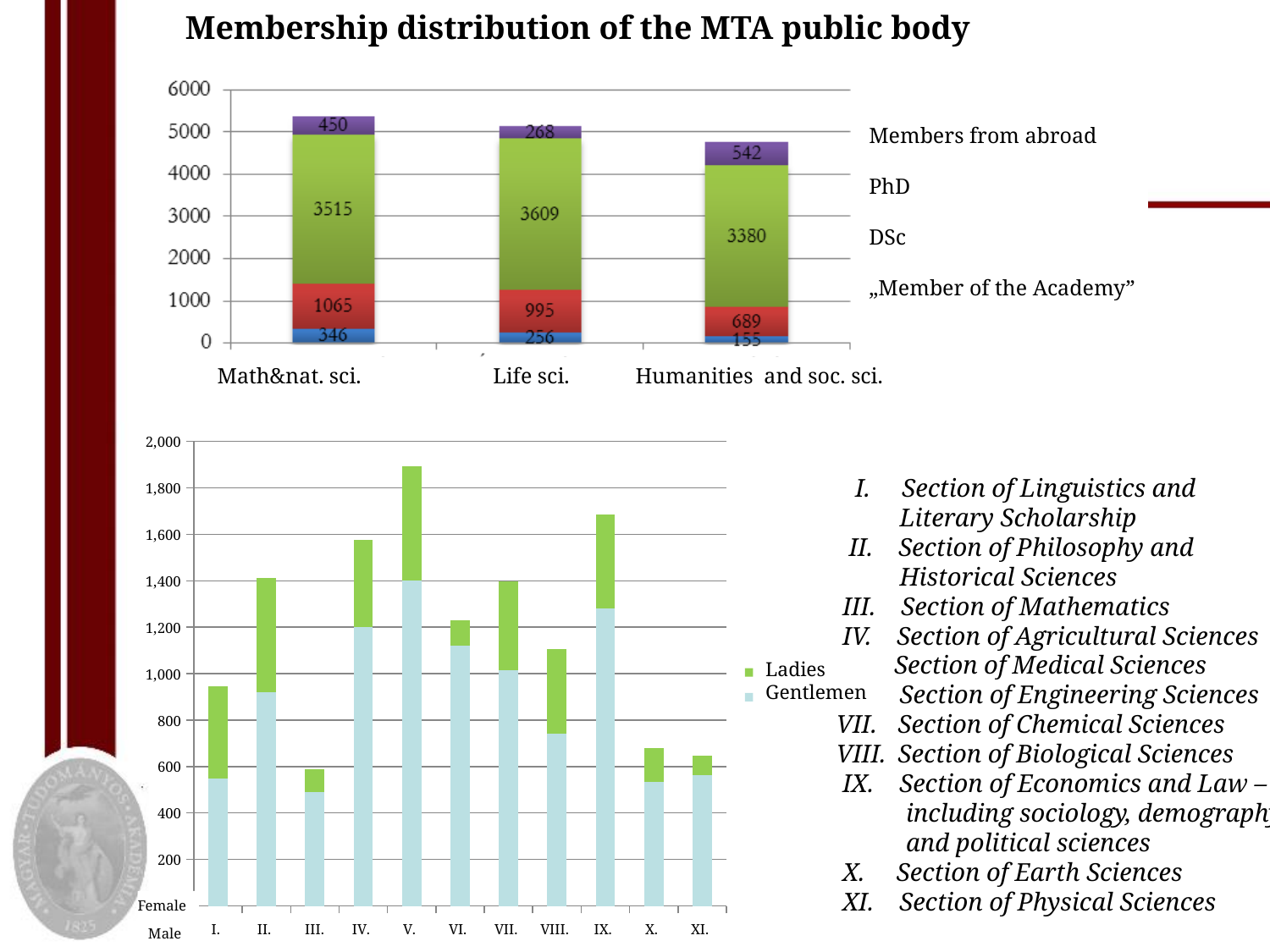
In the top chart, what is the difference between the DSc values for Math&nat. sci. and Life sci.? 70 In the top chart, which category has the highest Members from abroad value? Humanities and soc. sci. In the bottom chart, how many sections are shown on the x axis? 11 In the top chart, what is the total of the stacked bar for Life sci.? 5128 In the bottom chart, which section has the tallest stacked bar? V. In the bottom chart, is the Gentlemen value for section V. greater or less than 1,200? greater In the top chart, which category has the lowest "Member of the Academy" value? Humanities and soc. sci. In the top chart, what is the DSc value for Humanities and soc. sci.? 689 In the top chart, what is the PhD value for Life sci.? 3609 What kind of chart is the bottom chart? Stacked bar chart In the top chart, what is the Members from abroad value for Math&nat. sci.? 450 In the top chart, how many series does the legend list? 4